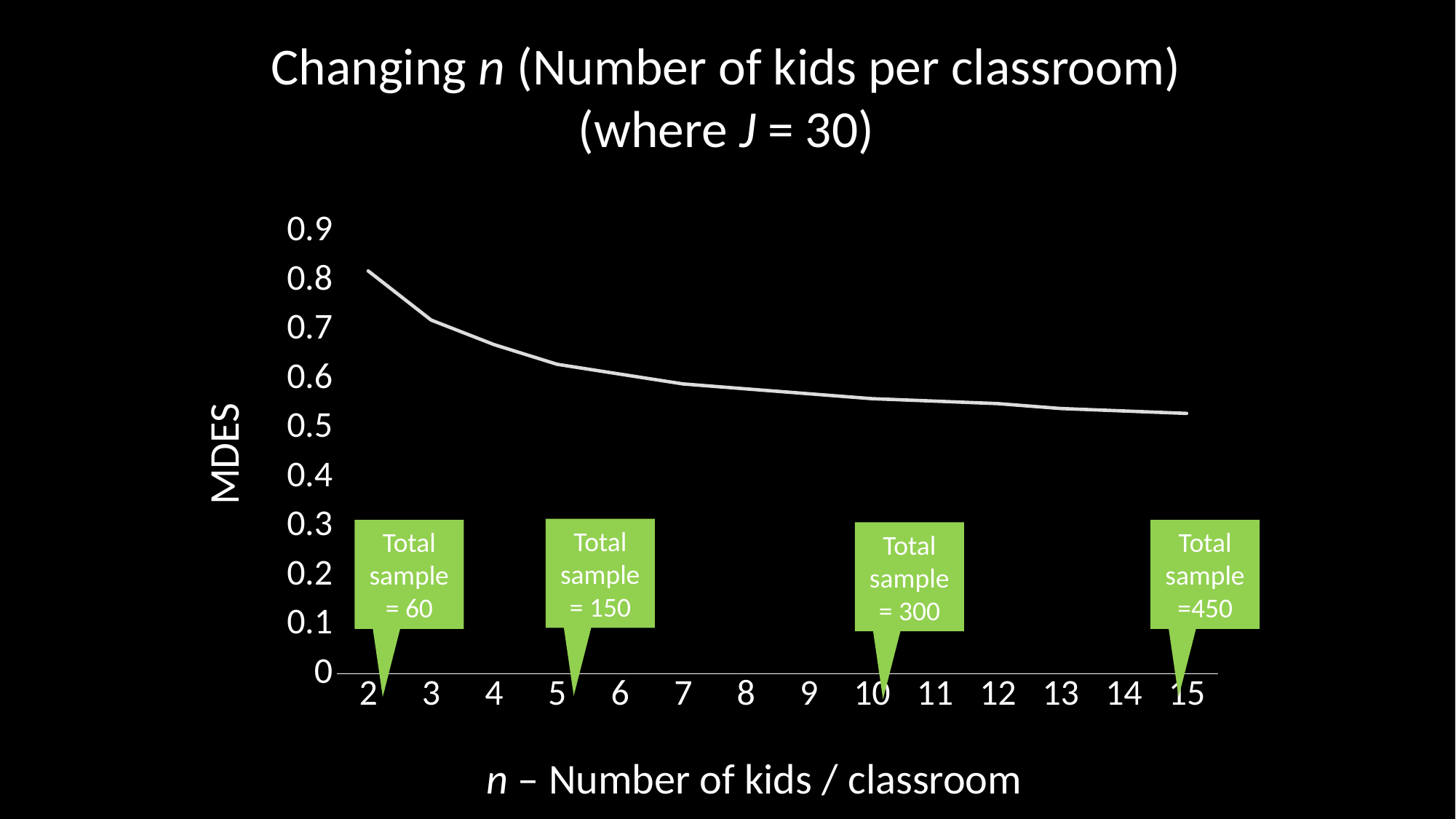
Which has the larger MDES, n = 3 or n = 12? n = 3 What kind of chart is shown on the slide? line chart At which value of n is MDES highest? 2 Is the MDES value for n = 15 greater or less than 0.6? less According to the callout, what is the total sample when n = 5? 150 Does MDES rise or fall as n (number of kids per classroom) increases? fall What is the label of the y axis? MDES Is the MDES value for n = 10 greater or less than 0.6? less Is the MDES value for n = 5 greater or less than 0.5? greater What is the title of the chart? Changing n (Number of kids per classroom) (where J = 30) At which value of n is MDES lowest? 15